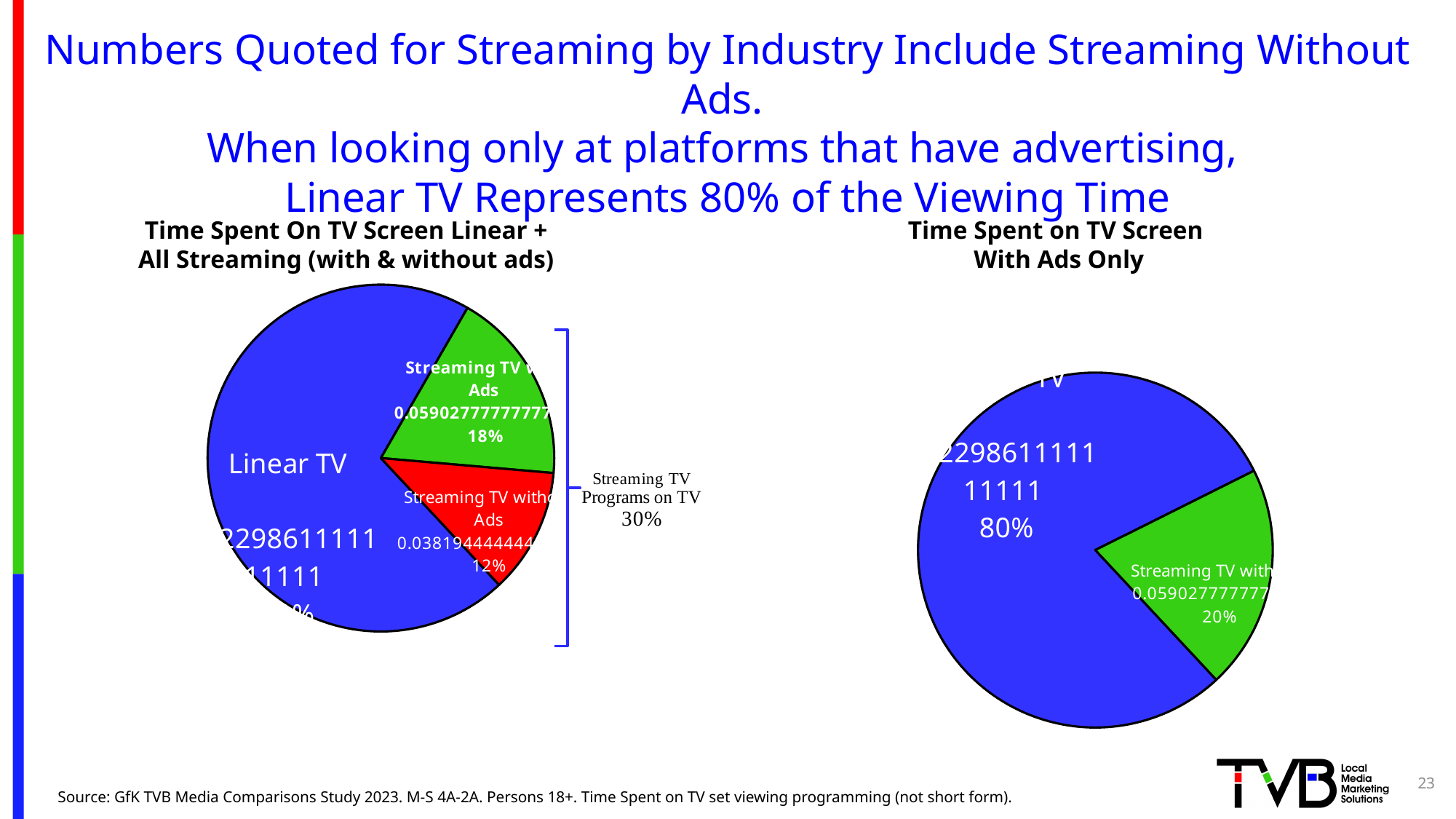
In the left pie chart, which slice is the smallest? Streaming TV without Ads In the left pie chart, what is the difference in percentage points between Streaming TV with Ads and Streaming TV without Ads? 6% How many slices does the 'Time Spent on TV Screen With Ads Only' pie chart have? 2 In the 'Time Spent on TV Screen With Ads Only' chart, what share of viewing time does Linear TV represent? 80% What kind of chart is the 'Time Spent On TV Screen Linear + All Streaming (with & without ads)' chart? Pie chart In the 'Time Spent on TV Screen With Ads Only' chart, which slice is the largest? Linear TV In the right pie chart, how many percentage points larger is Linear TV than Streaming TV with Ads? 60% In the 'Time Spent On TV Screen Linear + All Streaming (with & without ads)' chart, what percentage is shown for Streaming TV with Ads? 18% In the 'Time Spent on TV Screen With Ads Only' chart, what share does Streaming TV with Ads represent? 20% In the left pie chart, what combined share is shown for Streaming TV Programs on TV (with and without ads)? 30% How many slices does the 'Time Spent On TV Screen Linear + All Streaming (with & without ads)' pie chart have? 3 In the 'Time Spent On TV Screen Linear + All Streaming (with & without ads)' chart, what percentage is shown for Streaming TV without Ads? 12%